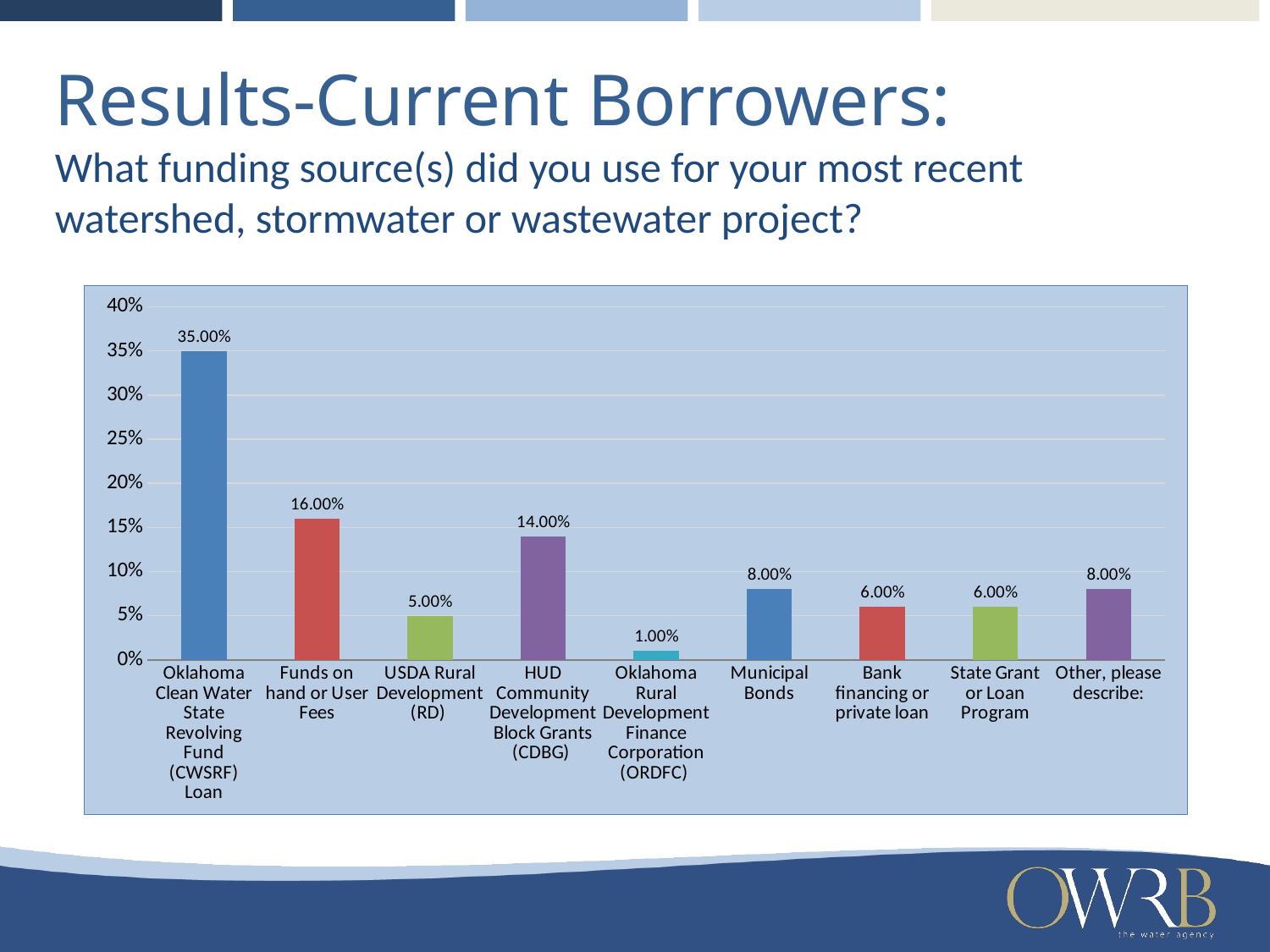
Which is larger, the value for Municipal Bonds or the value for Bank financing or private loan? Municipal Bonds What is the difference between the values for Funds on hand or User Fees and USDA Rural Development (RD)? 11.00% What value is shown for Funds on hand or User Fees? 16.00% How many funding source categories are shown on the chart? 9 Which funding source has the highest value? Oklahoma Clean Water State Revolving Fund (CWSRF) Loan What kind of chart is shown on the slide? Bar chart What is the maximum value shown on the vertical axis? 40% Which funding source has the lowest value? Oklahoma Rural Development Finance Corporation (ORDFC) What percentage of current borrowers used the Oklahoma Clean Water State Revolving Fund (CWSRF) Loan? 35.00% Is the value for HUD Community Development Block Grants (CDBG) greater or less than 10%? greater What value is shown for HUD Community Development Block Grants (CDBG)? 14.00% What value is shown for Oklahoma Rural Development Finance Corporation (ORDFC)? 1.00%